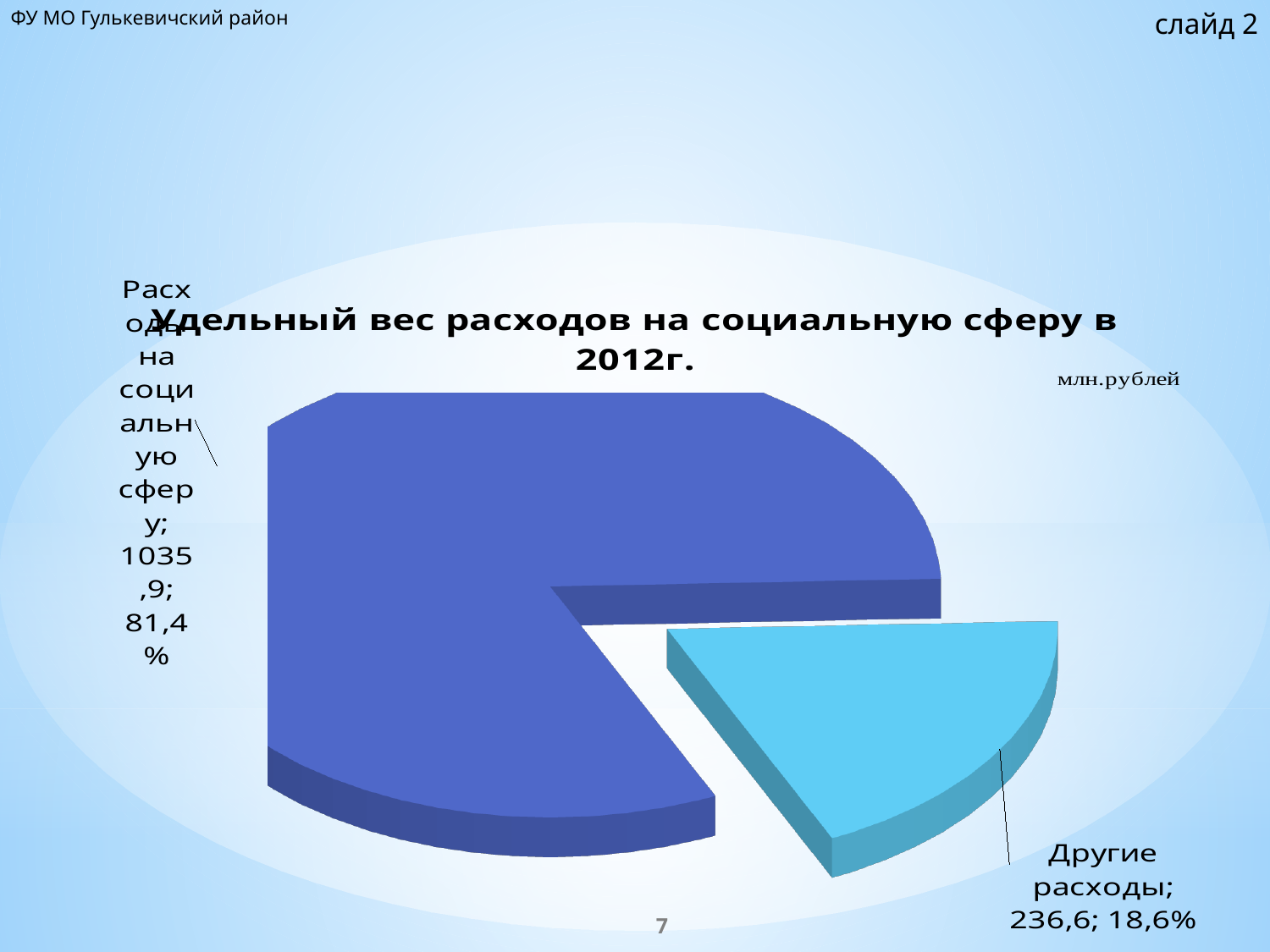
What kind of chart is shown on the slide? pie chart Which is larger, Расходы на социальную сферу or Другие расходы? Расходы на социальную сферу Which slice is the largest? Расходы на социальную сферу What is the value for Другие расходы? 236,6 What is the title of the chart? Удельный вес расходов на социальную сферу в 2012г. What share of the pie does Расходы на социальную сферу take? 81,4% What unit of measurement is indicated on the chart? млн.рублей What is the value for Расходы на социальную сферу? 1035,9 How many slices does the pie chart have? 2 What is the difference between the values for Расходы на социальную сферу and Другие расходы? 799,3 What share of the pie does Другие расходы take? 18,6% Which slice is the smallest? Другие расходы